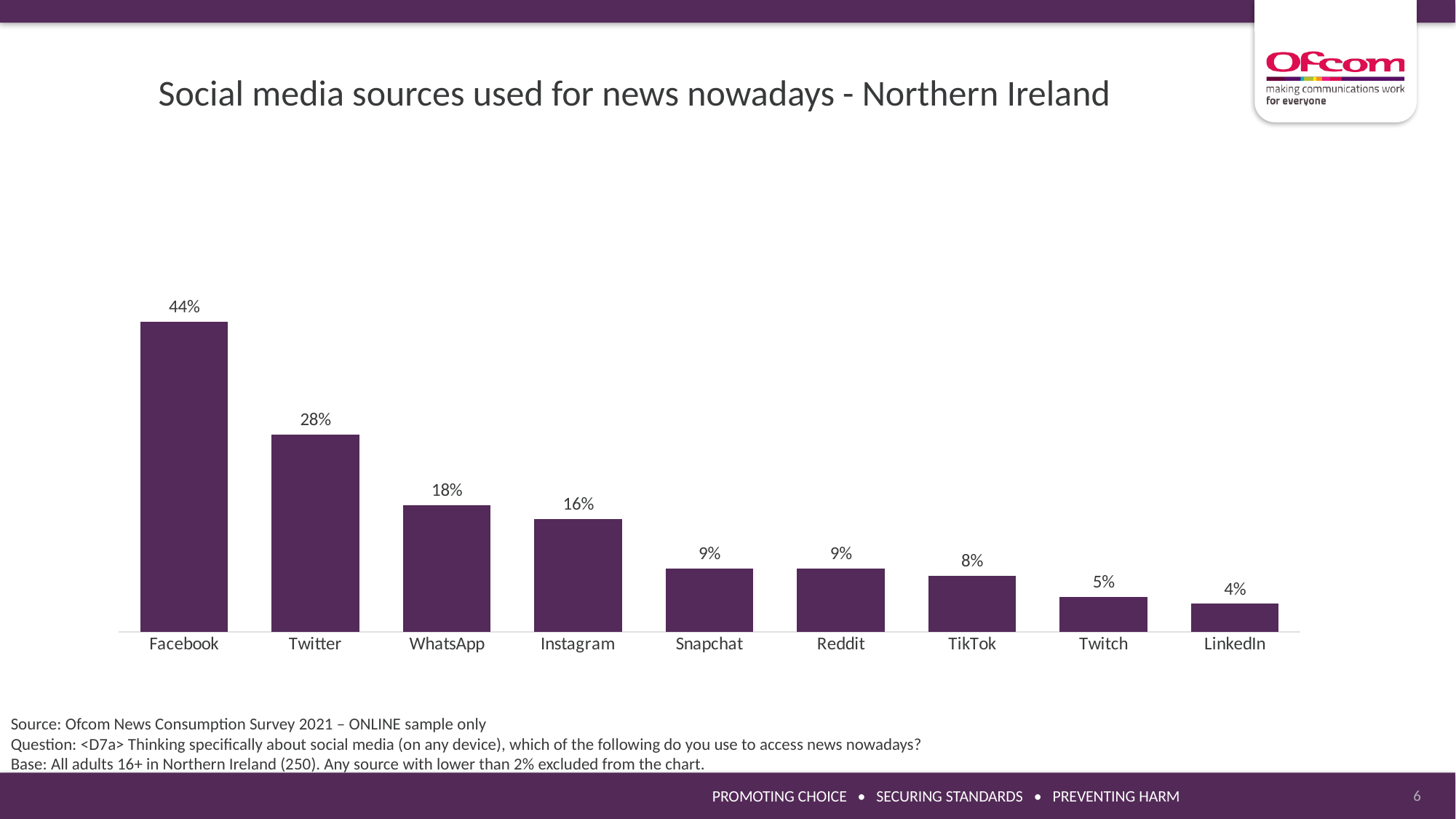
How many social media sources are shown on the chart? 9 Which social media source has the highest value on the chart? Facebook Do the values rise or fall moving from left to right along the x axis? Fall What is the difference between the values for Instagram and Twitch? 11% Which social media source has the lowest value on the chart? LinkedIn What is the title of the chart? Social media sources used for news nowadays - Northern Ireland What is the value shown for WhatsApp? 18% What percentage of adults in Northern Ireland use Facebook for news? 44% What kind of chart is shown on the slide? Bar chart What is the value shown for TikTok? 8% What is the difference between the values for Facebook and Twitter? 16% Which has a larger value, WhatsApp or Instagram? WhatsApp